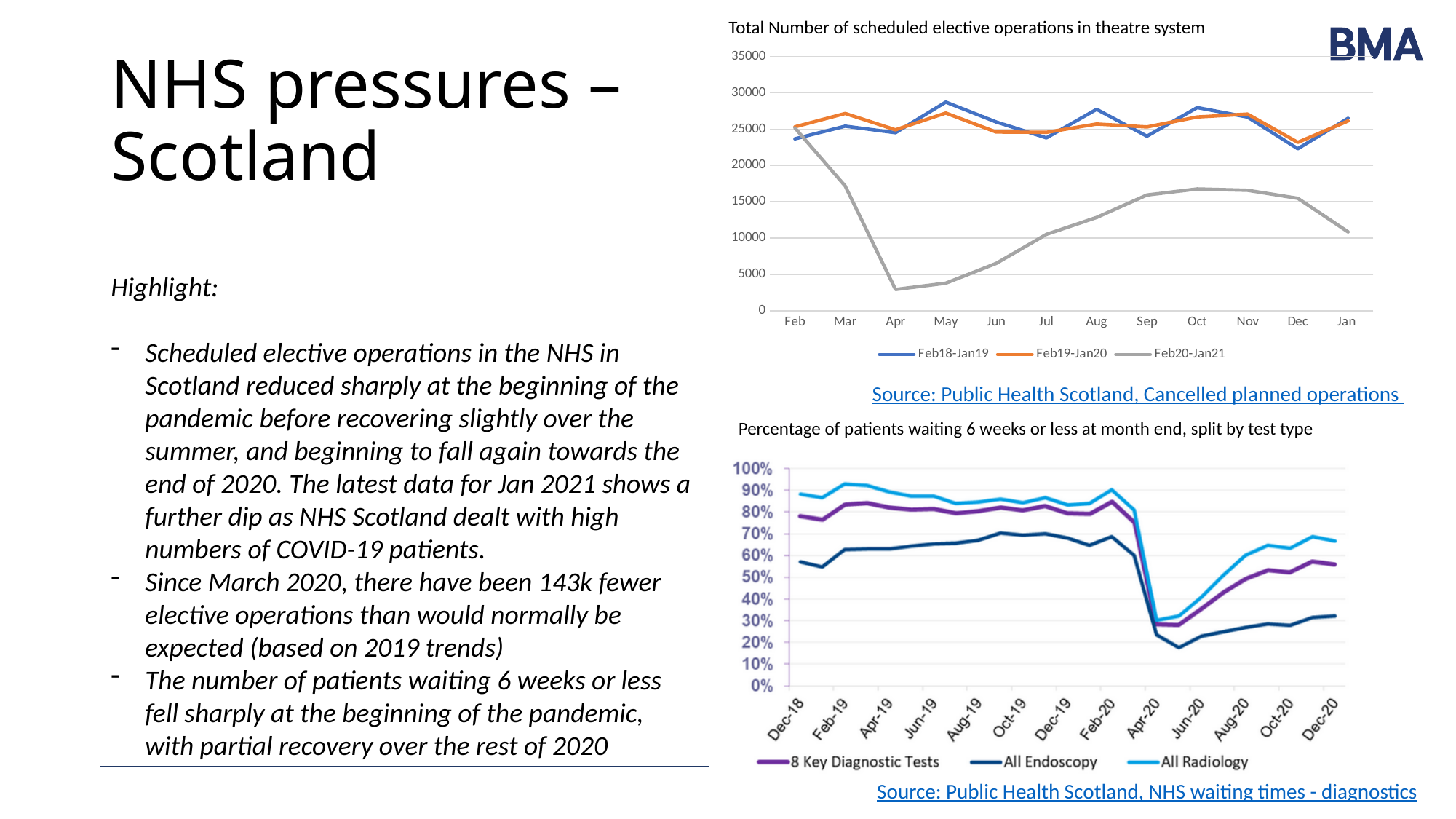
In the top chart, 'Total Number of scheduled elective operations in theatre system', does the Feb20-Jan21 series rise or fall from Feb to Apr? Fall How many series does the legend of the top chart, 'Total Number of scheduled elective operations in theatre system', list? 3 What are the three series named in the legend of the bottom chart, 'Percentage of patients waiting 6 weeks or less at month end, split by test type'? 8 Key Diagnostic Tests, All Endoscopy, All Radiology How many months are shown on the x axis of the top chart, 'Total Number of scheduled elective operations in theatre system'? 12 In the top chart, 'Total Number of scheduled elective operations in theatre system', in which month is the Feb20-Jan21 series lowest? Apr What kind of chart is the bottom chart, 'Percentage of patients waiting 6 weeks or less at month end, split by test type'? Line chart What kind of chart is the top chart, 'Total Number of scheduled elective operations in theatre system'? Line chart In the bottom chart, 'Percentage of patients waiting 6 weeks or less at month end, split by test type', is the value for All Endoscopy in Apr-20 greater or less than 30%? less How many series does the legend of the bottom chart, 'Percentage of patients waiting 6 weeks or less at month end, split by test type', list? 3 In the top chart, 'Total Number of scheduled elective operations in theatre system', is the value for Feb20-Jan21 in Apr greater or less than 5000? less In the top chart, 'Total Number of scheduled elective operations in theatre system', is the value for Feb20-Jan21 in Oct greater or less than 15000? greater In the top chart, 'Total Number of scheduled elective operations in theatre system', which series has the larger value in Apr: Feb19-Jan20 or Feb20-Jan21? Feb19-Jan20